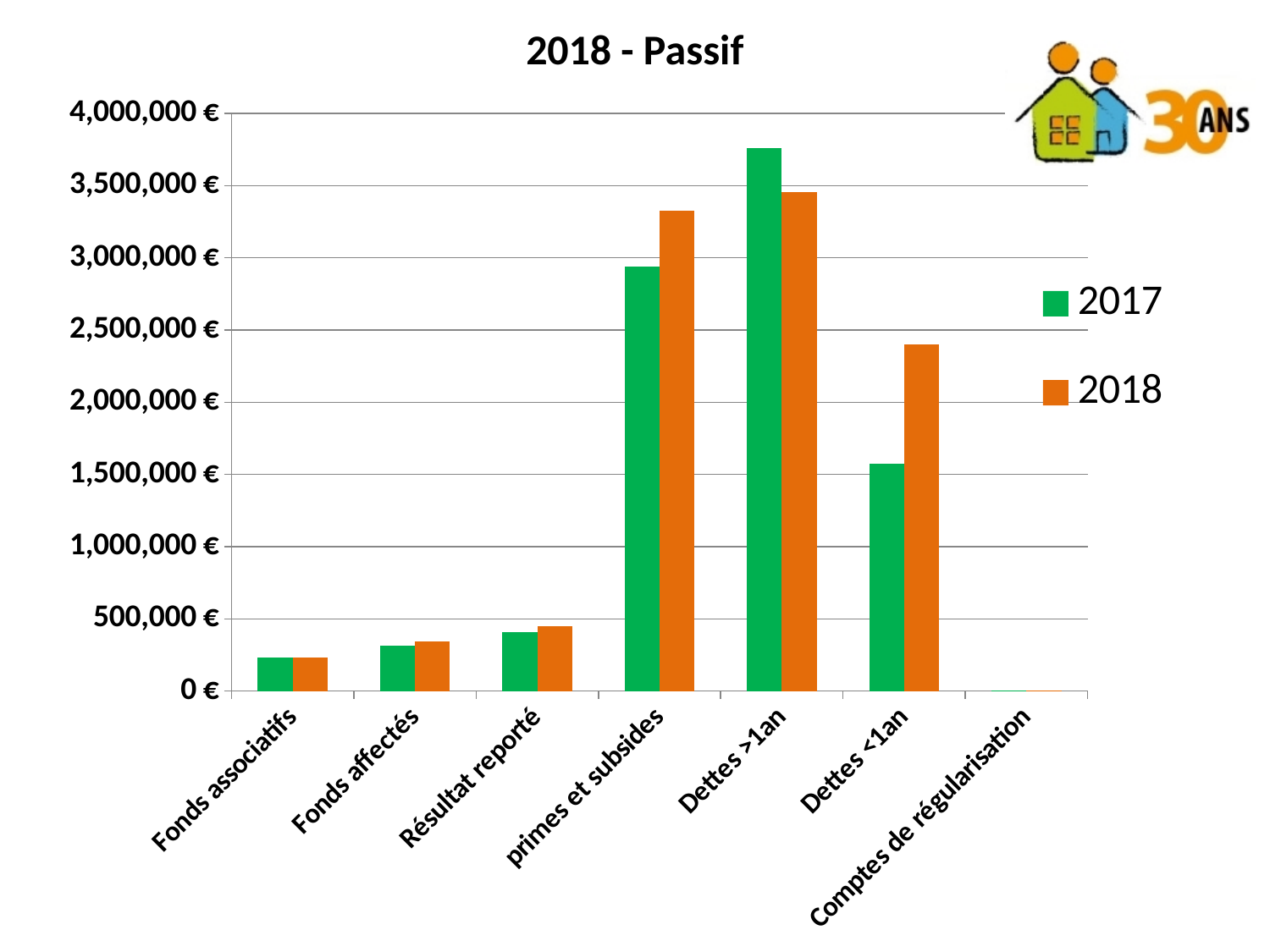
How many series does the legend list? 2 Is the 2017 value for primes et subsides greater or less than 3,000,000 €? less Is the 2017 value for Dettes >1an greater or less than 3,500,000 €? greater For Dettes >1an, which year has the larger value, 2017 or 2018? 2017 What kind of chart is shown on the slide? bar chart Which category has the lowest value for 2018? Comptes de régularisation What is the title of the chart? 2018 - Passif For Dettes <1an, which year has the larger value, 2017 or 2018? 2018 Is the 2018 value for Dettes <1an greater or less than 2,500,000 €? less Which category has the highest value for 2017? Dettes >1an Which colour represents the 2018 series in the legend? orange How many categories are shown on the x axis? 7